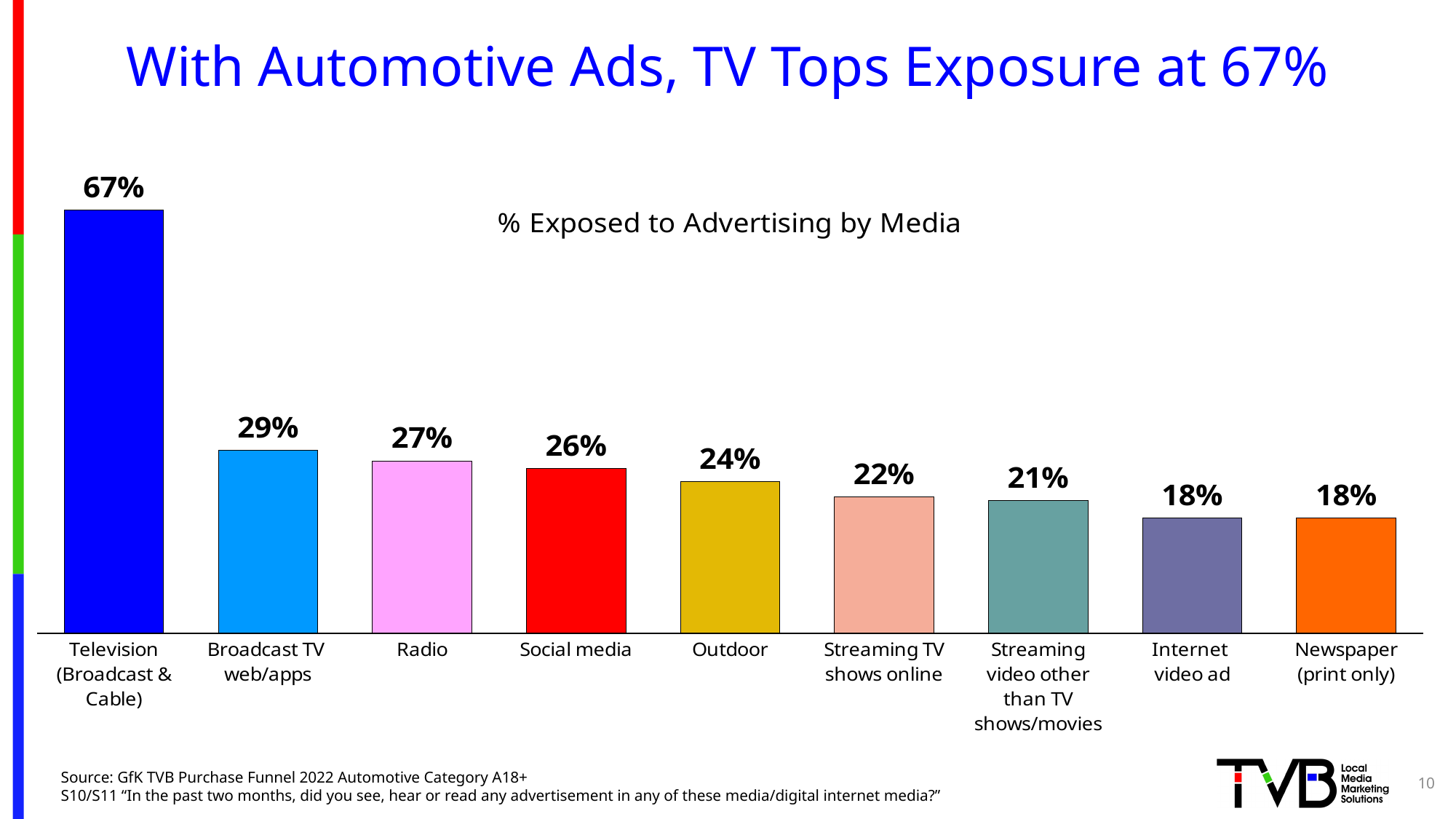
What percentage of respondents were exposed to automotive advertising on Television (Broadcast & Cable)? 67% What type of chart is shown on the slide? Bar chart Do the values rise or fall moving from left to right across the categories? Fall Which media category has the highest exposure percentage? Television (Broadcast & Cable) What is the lowest value shown on the chart? 18% How many media categories are shown on the chart? 9 What is the value shown for Radio? 27% What is the title of the chart? % Exposed to Advertising by Media Which is larger, the value for Radio or the value for Streaming video other than TV shows/movies? Radio What is the value shown for Streaming TV shows online? 22% What is the difference between the Television (Broadcast & Cable) value and the Broadcast TV web/apps value? 38 percentage points What is the difference between Social media and Outdoor? 2 percentage points